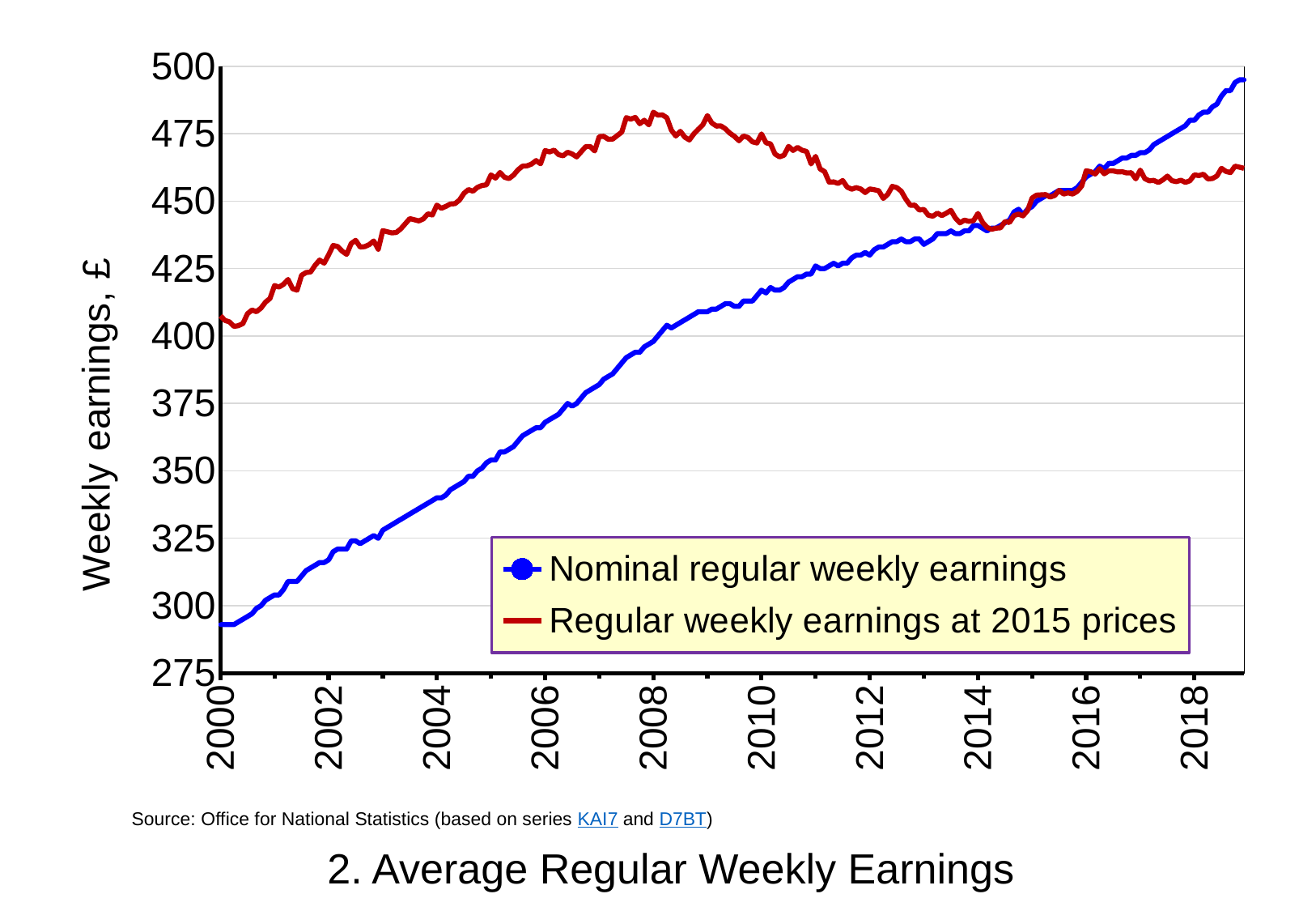
Is the value for Nominal regular weekly earnings in 2010 greater or less than 400? greater What kind of chart is shown on the slide? line chart Is the value for Regular weekly earnings at 2015 prices in 2014 greater or less than 450? less What is the title of the chart? 2. Average Regular Weekly Earnings Does the Nominal regular weekly earnings series rise or fall from 2000 to 2018? rise What is the label on the vertical axis? Weekly earnings, £ In 2018, which series has the higher value: Nominal regular weekly earnings or Regular weekly earnings at 2015 prices? Nominal regular weekly earnings Is the value for Nominal regular weekly earnings in 2000 greater or less than 300? less Does the Regular weekly earnings at 2015 prices series rise or fall between 2008 and 2014? fall In 2004, which series has the higher value: Nominal regular weekly earnings or Regular weekly earnings at 2015 prices? Regular weekly earnings at 2015 prices How many series does the legend list? 2